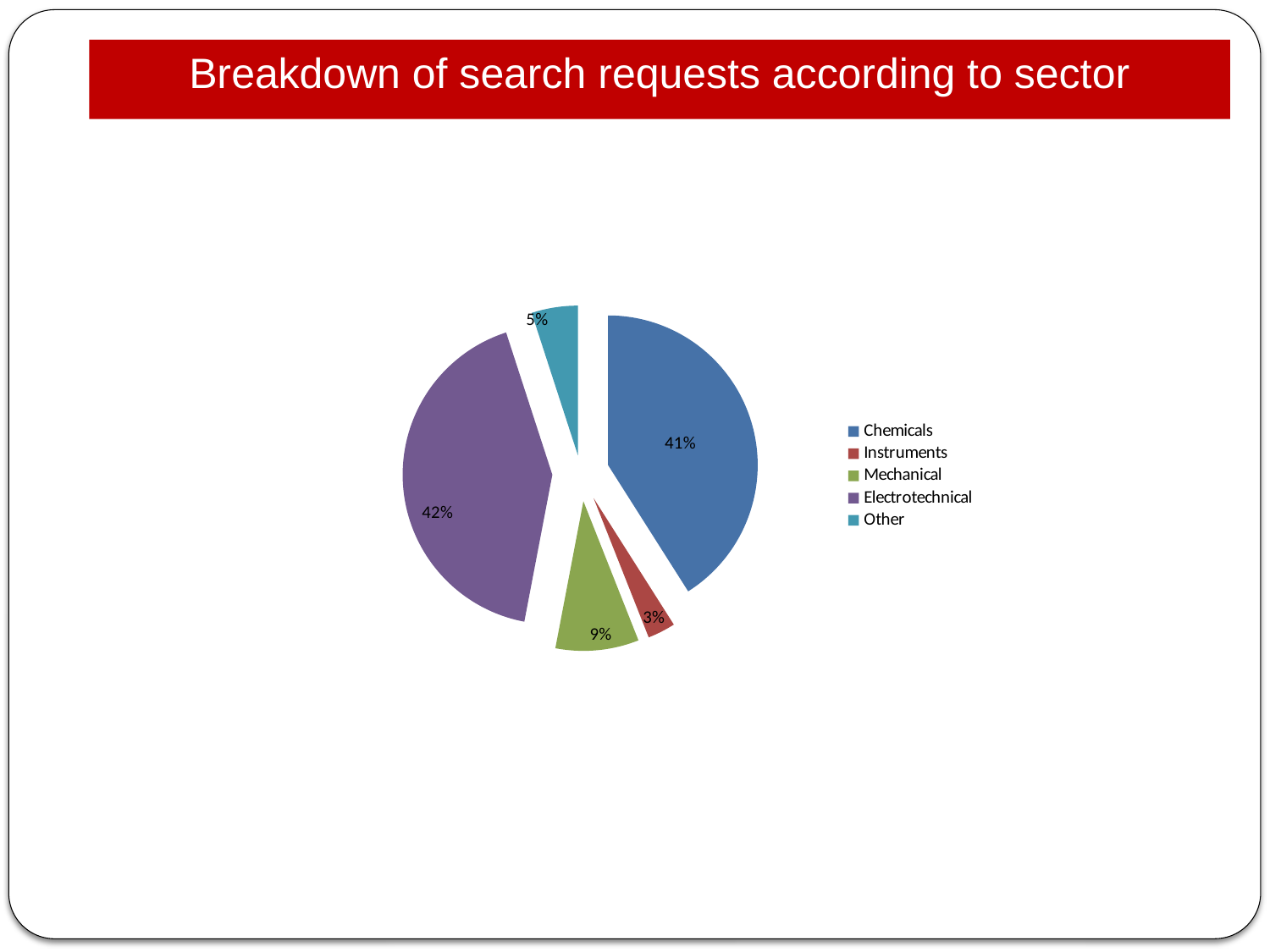
What is the title of the chart? Breakdown of search requests according to sector Which sector has the largest share of search requests? Electrotechnical What is the share of search requests for the Mechanical sector? 9% How many sectors are shown in the pie chart? 5 What is the difference in percentage points between the Mechanical and Instruments shares? 6 Which sector has the smallest share of search requests? Instruments Which has a larger share of search requests, Mechanical or Other? Mechanical What share of search requests does the Chemicals sector account for? 41% What share of search requests is labelled Other? 5% What type of chart is shown on the slide? Pie chart